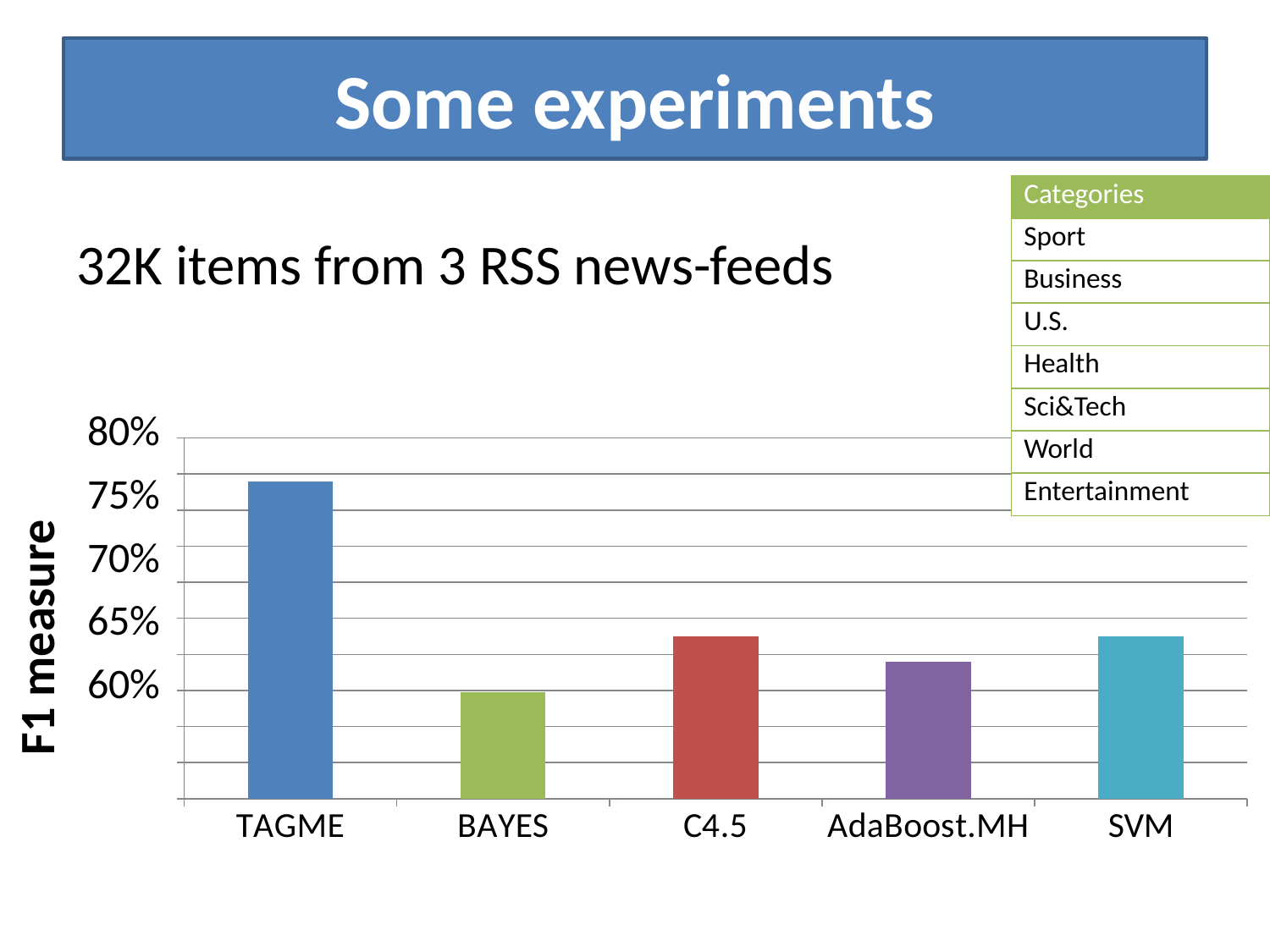
Which has a higher F1 measure, TAGME or BAYES? TAGME Is the F1 measure for C4.5 greater or less than 65%? less Is the F1 measure for TAGME greater or less than 75%? greater How many methods (bars) are plotted in the chart? 5 What is the label of the vertical axis of the chart? F1 measure Is the F1 measure for SVM greater or less than 70%? less What kind of chart is shown on the slide? bar chart Which has a higher F1 measure, C4.5 or AdaBoost.MH? C4.5 Which method has the highest F1 measure in the chart? TAGME Which method's bar is coloured blue in the chart? TAGME Which method has the lowest F1 measure in the chart? BAYES